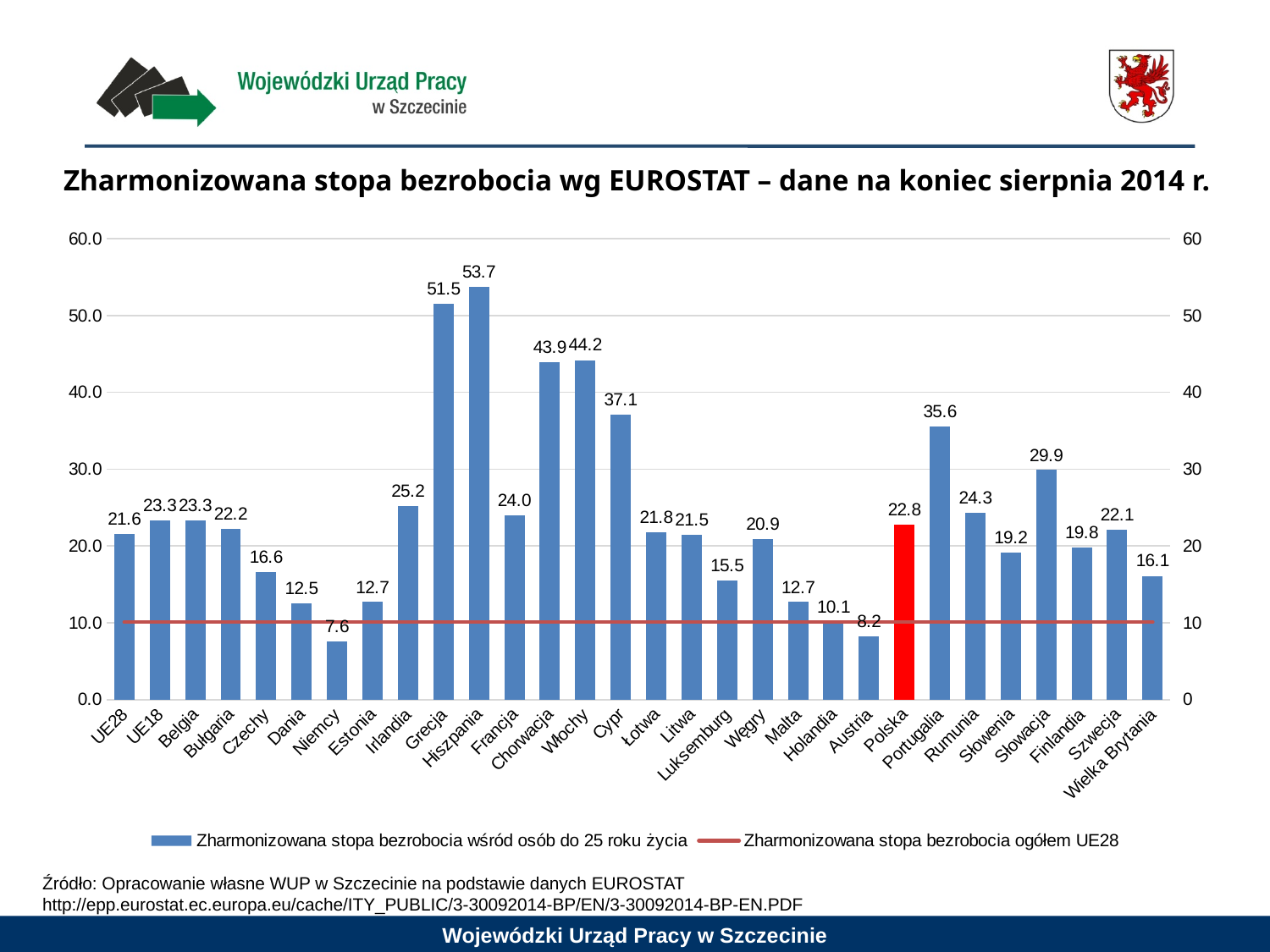
Which category has the highest value? Hiszpania How many categories are shown on the x axis? 30 Is the value for Austria greater or less than 10? less What is the difference between the values for Hiszpania and Grecja? 2.2 Which is larger, the value for Cypr or the value for Portugalia? Cypr Which category's bar is coloured red instead of blue? Polska What is the value for Niemcy? 7.6 How many series does the legend list? 2 What is the value for Polska? 22.8 Which category has the lowest value? Niemcy What is the difference between the values for Polska and UE28? 1.2 What is the value for Portugalia? 35.6